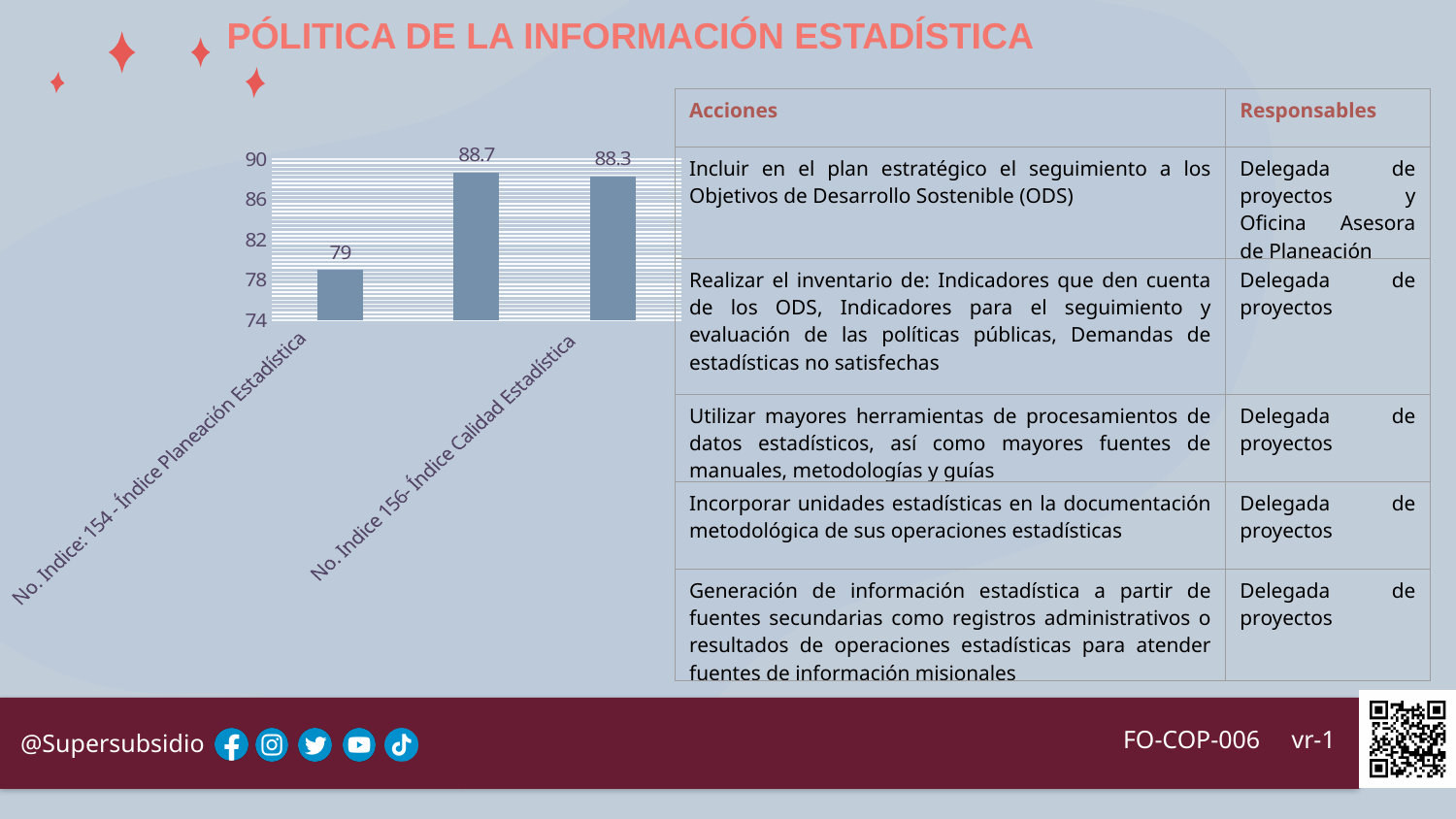
What is the value of the bar for 'No. Indice: 154 - Índice Planeación Estadística'? 79 How many bars are plotted in the chart? 3 What kind of chart is shown on the slide? bar chart Which bar has the lowest value in the chart? No. Indice: 154 - Índice Planeación Estadística What is the difference between the value of the second bar (88.7) and the third bar (88.3)? 0.4 What is the value of the bar for 'No. Indice 156- Índice Calidad Estadística'? 88.3 What is the difference between the values for Índice Calidad Estadística and Índice Planeación Estadística? 9.3 What is the highest tick value shown on the chart's vertical axis? 90 Which is larger, the value for Índice Planeación Estadística or the value for Índice Calidad Estadística? Índice Calidad Estadística What is the value shown on the rightmost (third) bar of the chart? 88.3 Which bar has the highest value in the chart? The second (middle) bar, with 88.7 Is the value for Índice Planeación Estadística greater or less than 82? less